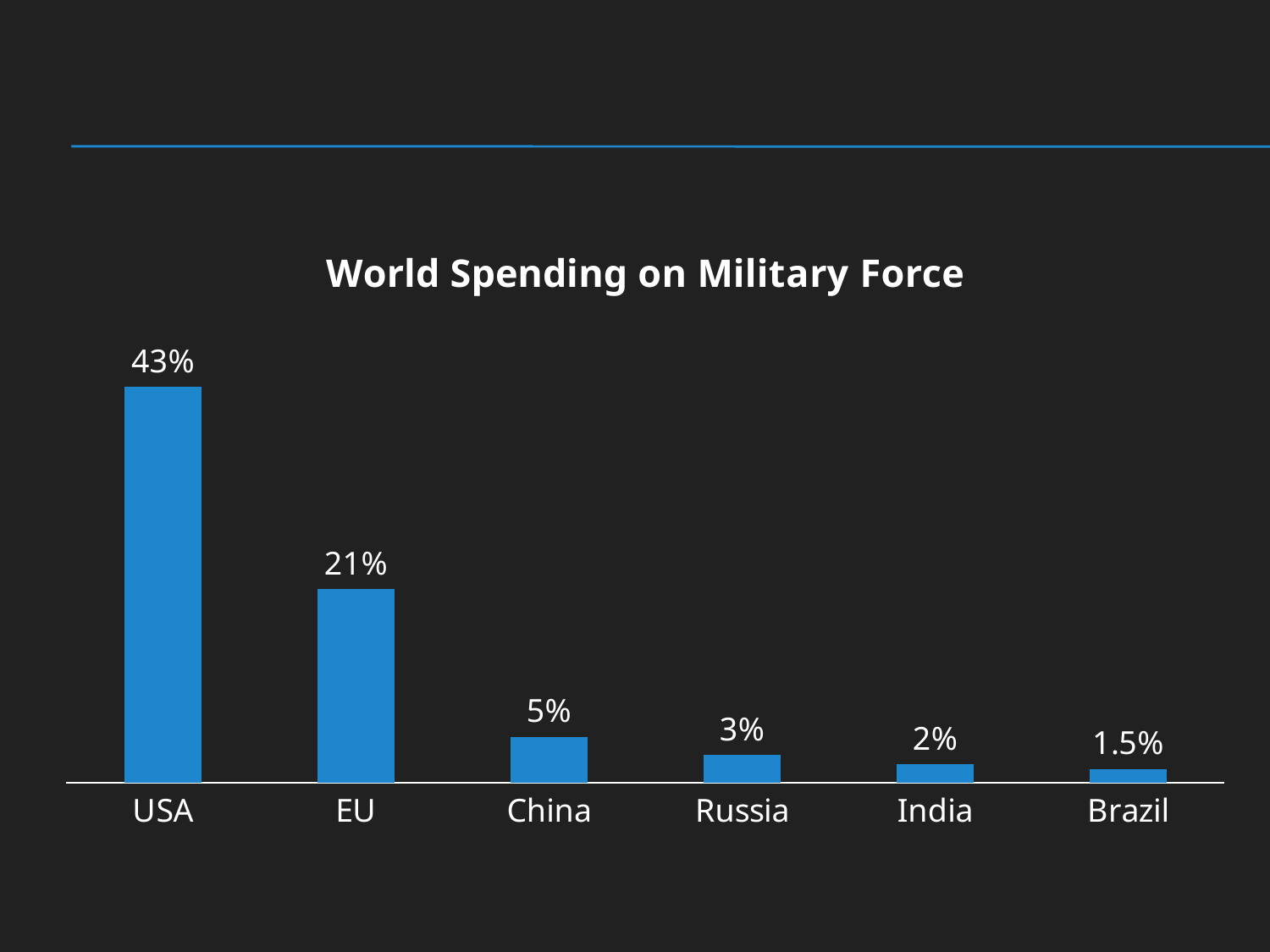
What is the value for USA? 43% What is the value for Brazil? 1.5% What is the value for EU? 21% Which category has the lowest value? Brazil How many categories are shown in the chart? 6 What is the difference between the values for USA and EU? 22% What is the value for China? 5% Which is larger, the value for Russia or the value for India? Russia What is the title of the chart? World Spending on Military Force Which category has the highest value? USA What kind of chart is this? Bar chart What is the difference between the values for China and Russia? 2%